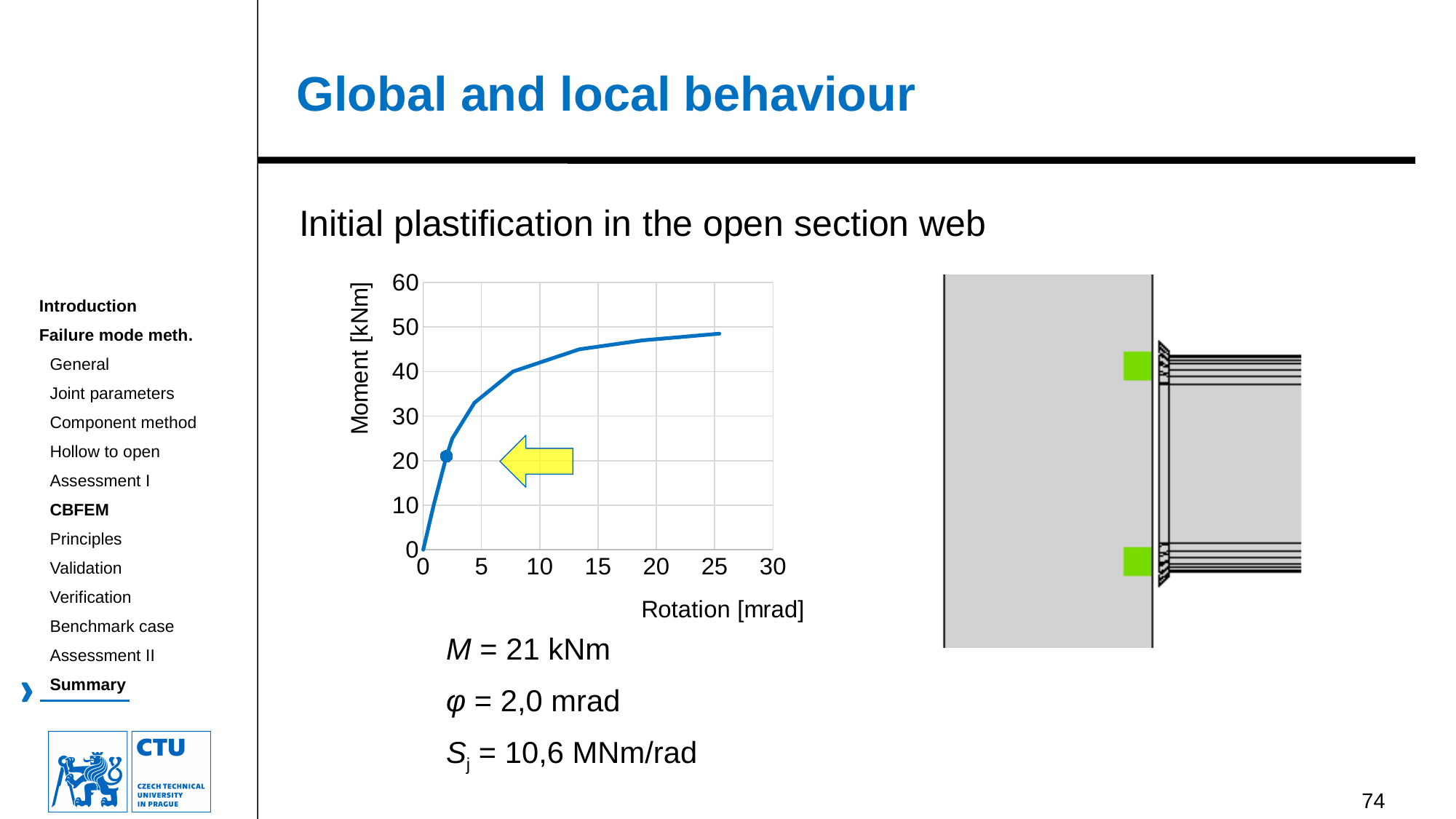
What is the label of the vertical axis of the chart? Moment [kNm] What is the highest value shown on the horizontal axis of the chart? 30 Is the moment at a rotation of 5 mrad greater or less than 20 kNm? greater What is the moment M at the marked point on the curve? 21 kNm Is the moment at a rotation of 10 mrad greater or less than 30 kNm? greater Is the moment at a rotation of 25 mrad greater or less than 40 kNm? greater What is the highest value shown on the vertical axis of the chart? 60 Does the moment rise or fall as the rotation increases along the x axis? rises What kind of chart is shown on the slide? line chart What is the label of the horizontal axis of the chart? Rotation [mrad] What is the rotation φ at the marked point on the curve? 2,0 mrad